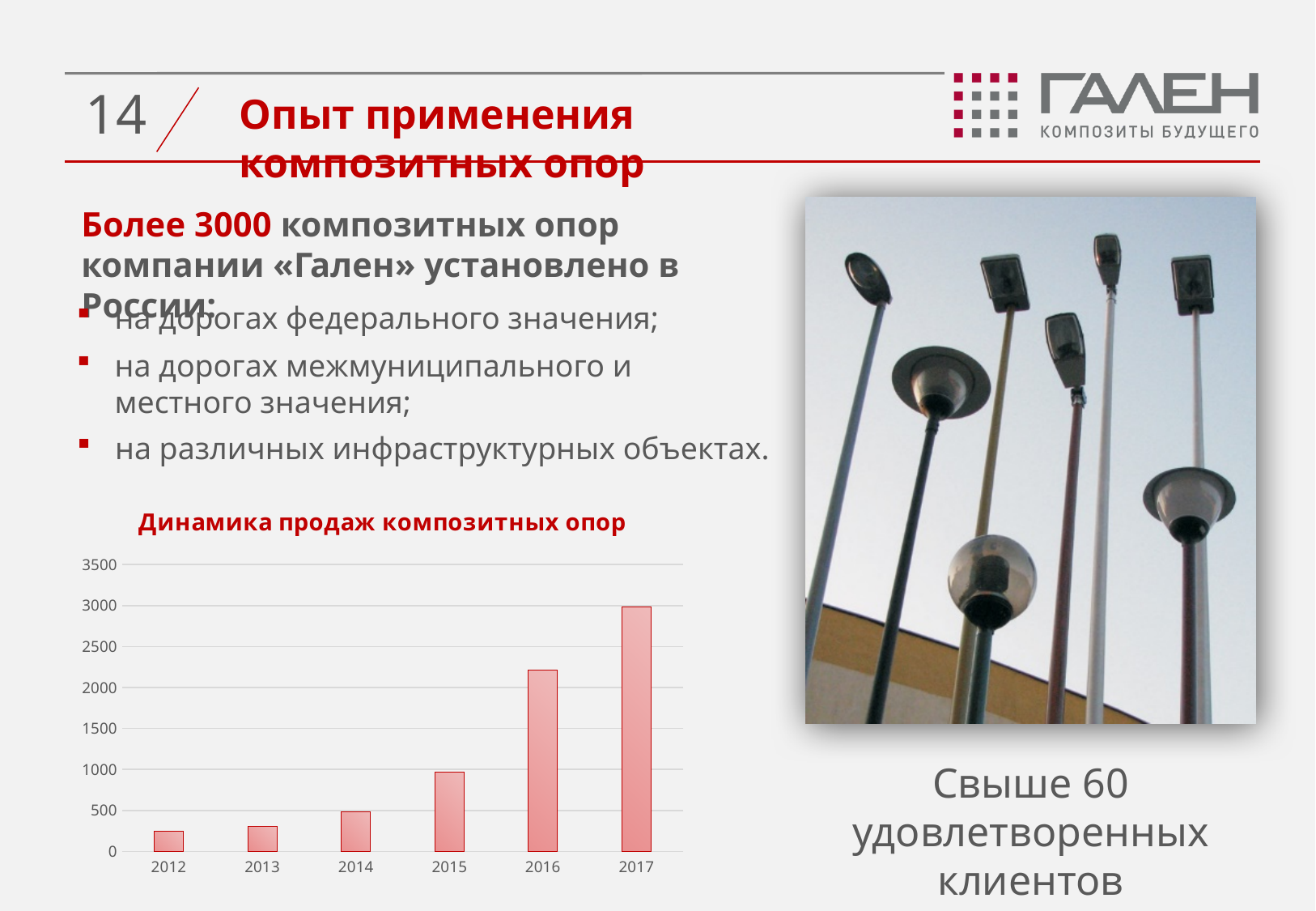
What is the highest value shown on the chart's vertical axis? 3500 Which year has the highest bar in the chart? 2017 What is the title of the chart on the slide? Динамика продаж композитных опор Which year has the larger value, 2014 or 2015? 2015 Which year has the larger value, 2016 or 2017? 2017 Is the value for 2017 greater or less than 2500? greater Do the values in the chart rise or fall from 2012 to 2017? rise Is the value for 2015 greater or less than 500? greater What kind of chart is shown on the slide? bar chart Is the value for 2016 greater or less than 2000? greater How many years are shown on the x axis of the chart? 6